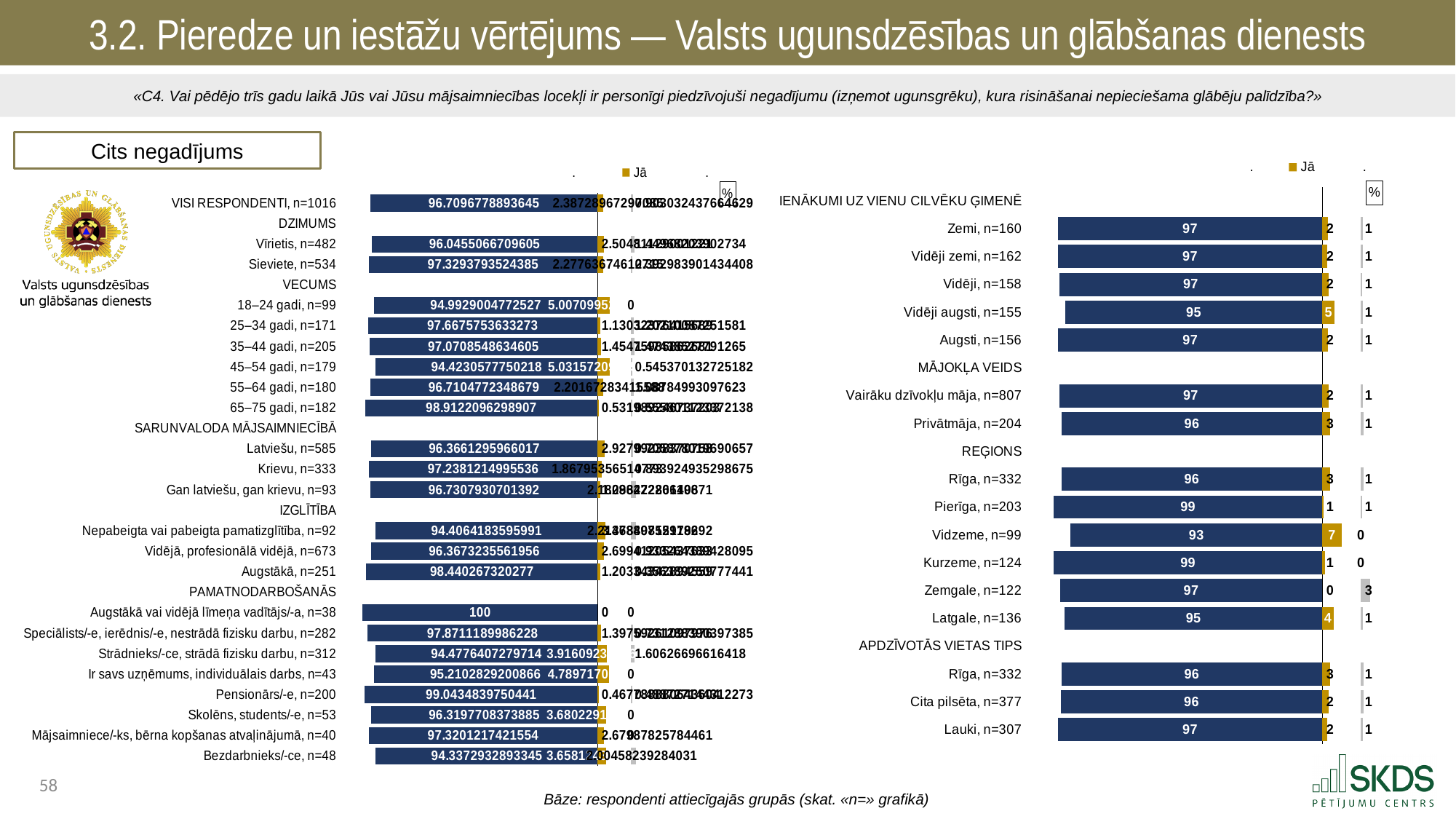
What type of chart is used on this slide? Bar chart In the right-hand chart, which region under REĢIONS has the lowest "Jā" value? Zemgale, n=122 In the right-hand chart, what is the "Jā" value for Pierīga, n=203? 1 In the right-hand chart, what is the "Jā" value for Latgale, n=136? 4 In the right-hand chart, what is the difference between the "Jā" values for Kurzeme, n=124 and Vidzeme, n=99? 6 In the left-hand chart, what is the "Jā" value for Augstākā vai vidējā līmeņa vadītājs/-a, n=38? 0 In the right-hand chart, what is the "Jā" value for Vidzeme, n=99? 7 In the right-hand chart, which has the larger "Jā" value: Vairāku dzīvokļu māja, n=807 or Privātmāja, n=204? Privātmāja, n=204 What is the labelled legend entry shown above the charts? Jā In the right-hand chart, what is the "Jā" value for Lauki, n=307? 2 In the right-hand chart, how many categories are listed under REĢIONS? 6